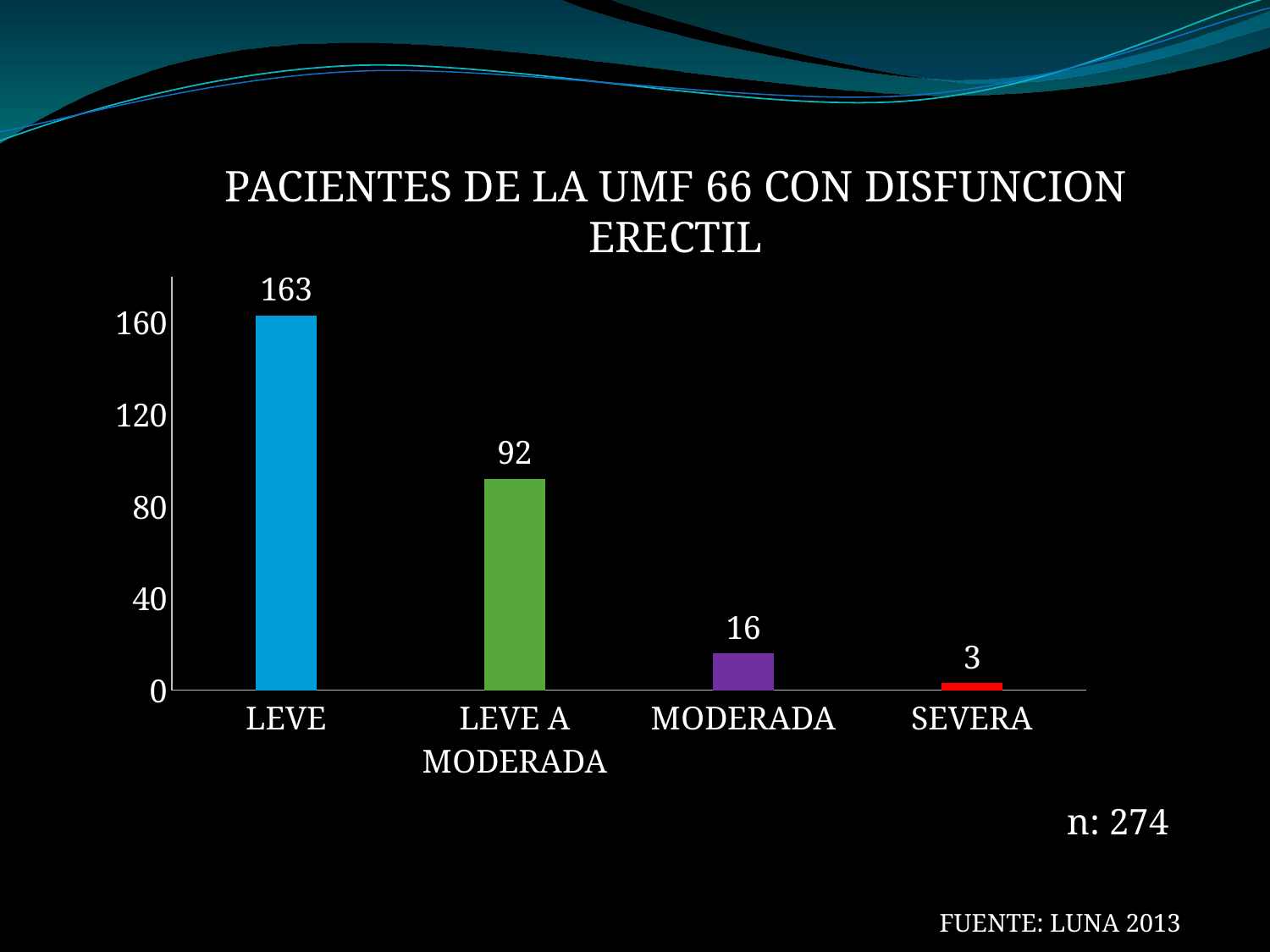
How many categories are shown on the x axis? 4 What is the value for SEVERA? 3 What is the title of the chart? PACIENTES DE LA UMF 66 CON DISFUNCION ERECTIL Which category has the highest value? LEVE What is the value for MODERADA? 16 What is the value for LEVE? 163 Which is larger, the value for MODERADA or the value for SEVERA? MODERADA Which category has the lowest value? SEVERA What kind of chart is this? bar chart What is the value for LEVE A MODERADA? 92 What is the difference between the values for LEVE and LEVE A MODERADA? 71 Is the value for LEVE A MODERADA greater or less than 80? greater